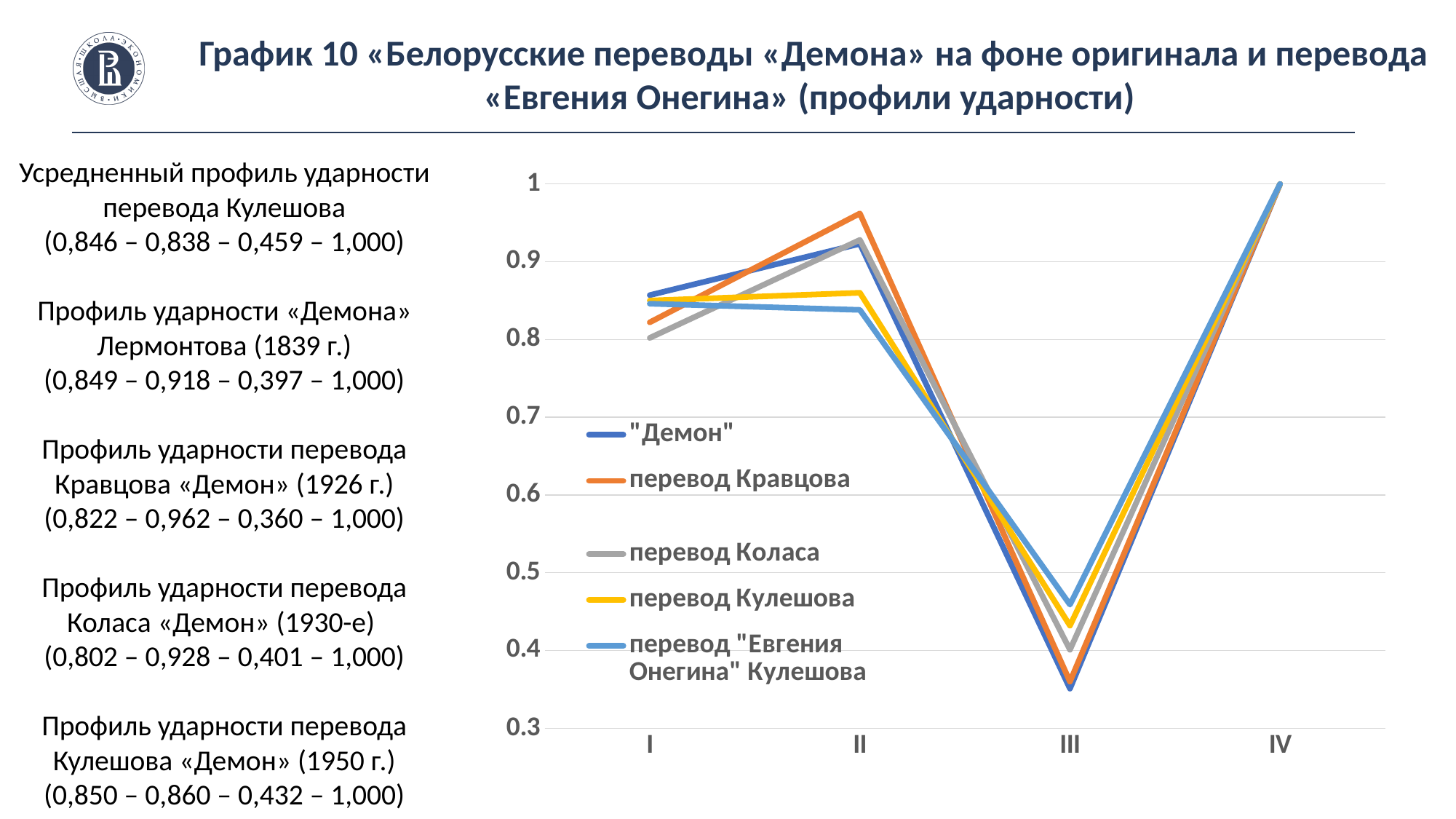
Which series has the highest value at position III? перевод "Евгения Онегина" Кулешова What kind of chart is shown on the slide? line chart According to the text on the slide, what is the value of перевод Коласа at position I? 0,802 Is the value for перевод Кулешова at position III greater or less than 0.5? less How many points are plotted along the x axis for each series? 4 According to the text on the slide, what is the value of перевод Кравцова at position II? 0,962 Which is larger at position I: the value for "Демон" or the value for перевод Коласа? "Демон" Do the values for all series rise or fall from position II to position III? fall What value do all series reach at position IV? 1,000 Which series has the highest value at position II? перевод Кравцова Which series has the lowest value at position III? "Демон" How many series does the legend list? 5